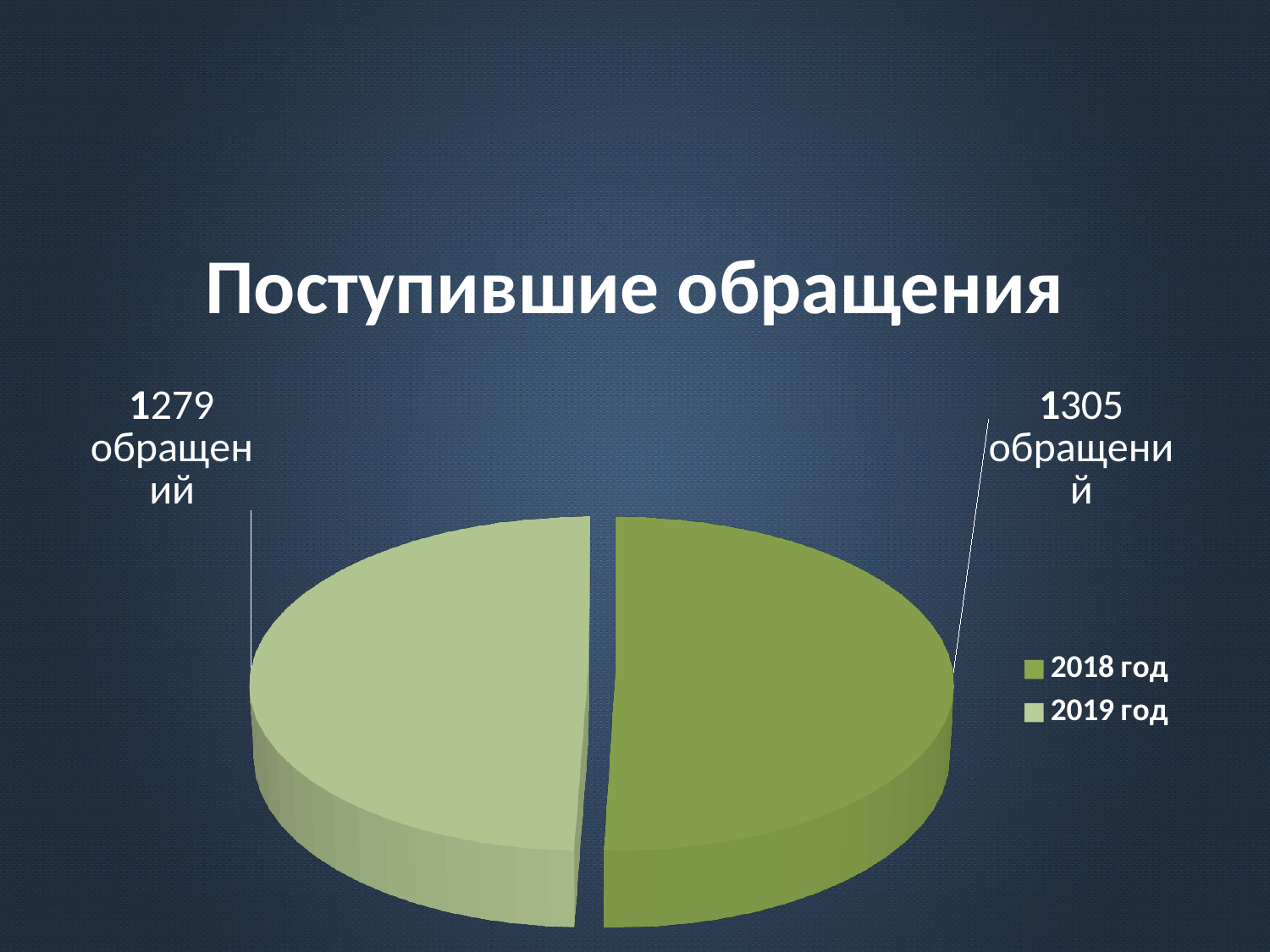
What value is shown for 2018 год? 1305 обращений What is the title of the chart? Поступившие обращения Which year has the larger number of обращения? 2018 год By how much does the value for 2018 год exceed the value for 2019 год? 26 Is the value for 2018 год larger or smaller than the value for 2019 год? larger What kind of chart is shown on the slide? pie chart What value is shown for 2019 год? 1279 обращений How many entries does the legend list? 2 Which year has the smaller number of обращения? 2019 год Which legend entry is shown in the lighter green colour? 2019 год How many slices does the pie chart have? 2 What is the total number of обращения across both years shown? 2584